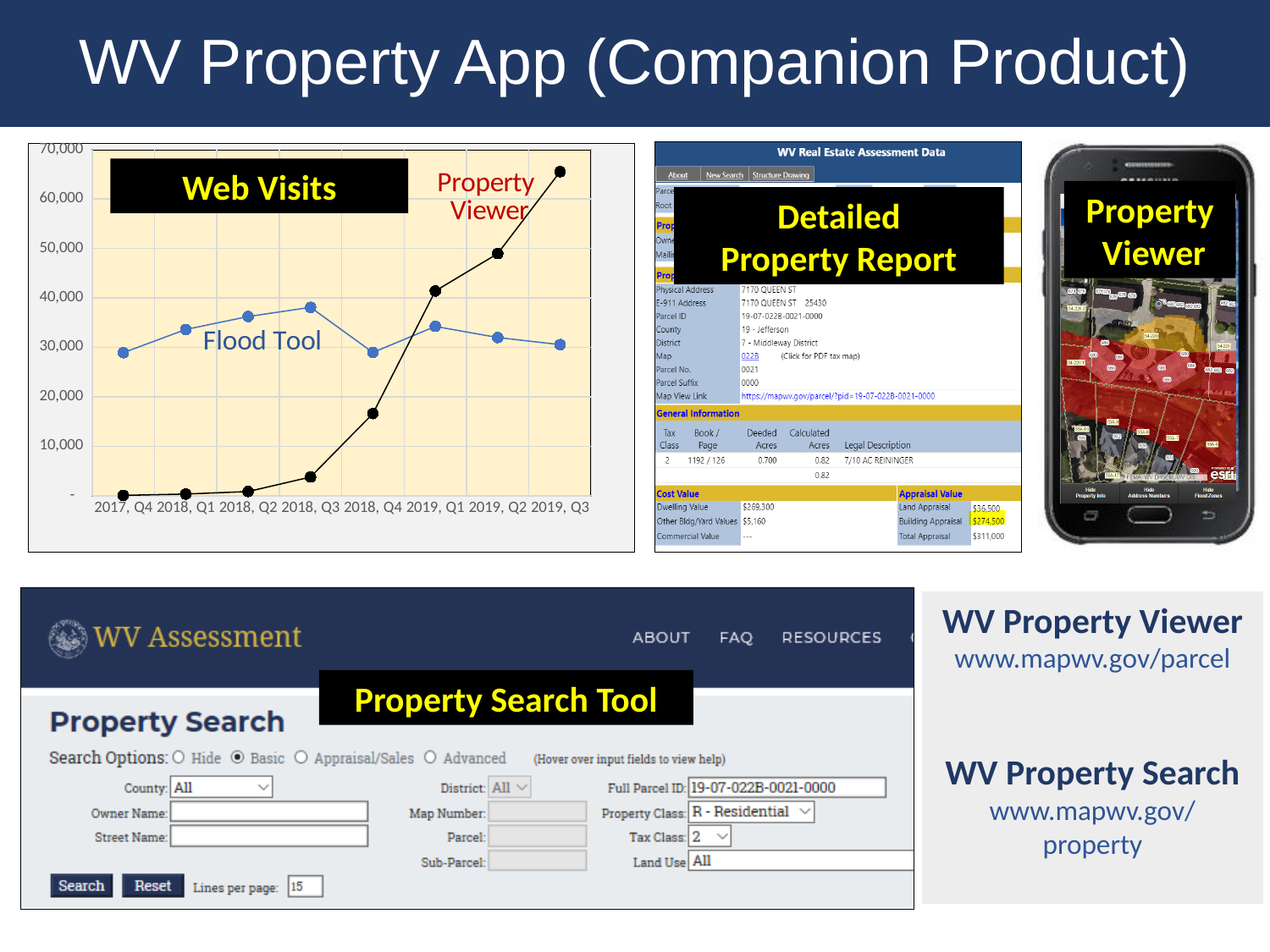
How many data series are plotted on the Web Visits chart? 2 In 2018, Q4, which series has the higher value, Property Viewer or Flood Tool? Flood Tool What kind of chart is the Web Visits chart? line chart What is the title of the chart on the slide? Web Visits In which quarter does the Flood Tool series reach its highest value? 2018, Q3 Does the Property Viewer series generally rise or fall from 2017, Q4 to 2019, Q3? rise Is the Property Viewer value for 2019, Q3 greater or less than 60,000? greater Is the Property Viewer value for 2018, Q4 greater or less than 20,000? less In which quarter does the Property Viewer series reach its highest value? 2019, Q3 In 2019, Q3, which series has the higher value, Property Viewer or Flood Tool? Property Viewer Is the Flood Tool value for 2018, Q3 greater or less than 40,000? less How many quarters are shown on the x axis of the Web Visits chart? 8